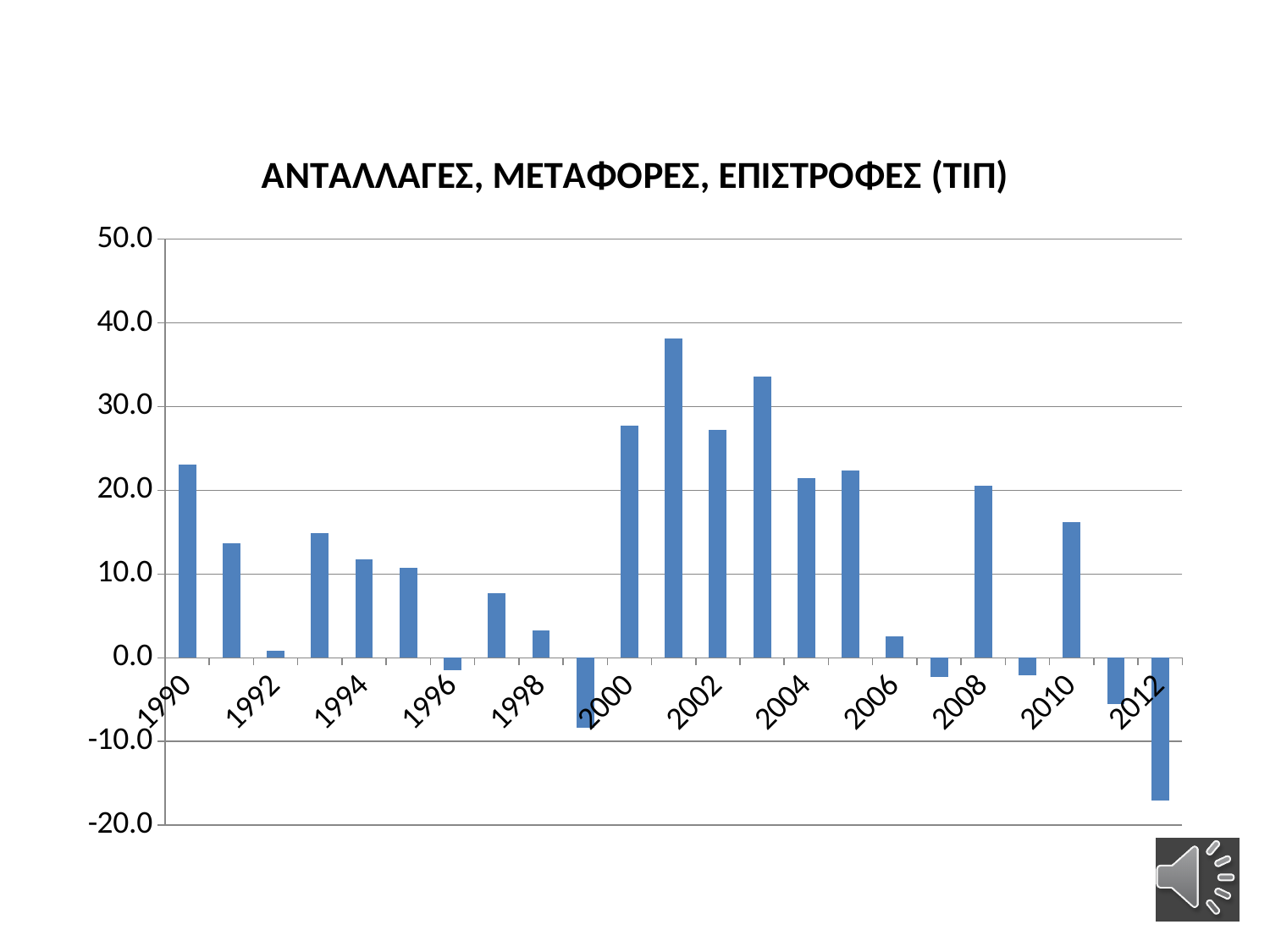
Which is larger, the value for 1990 or the value for 1991? 1990 What type of chart is shown on the slide? bar chart Is the value for 2001 greater or less than 30.0? greater How many bars (years) are plotted in the chart? 23 Is the value for 1990 greater or less than 20.0? greater Is the value for 2012 greater or less than -10.0? less Which year has the lowest value in the chart? 2012 What is the title of the chart? ΑΝΤΑΛΛΑΓΕΣ, ΜΕΤΑΦΟΡΕΣ, ΕΠΙΣΤΡΟΦΕΣ (ΤΙΠ) Do the values rise or fall from 2010 to 2012? fall Which year has the highest value in the chart? 2001 Which is larger, the value for 2001 or the value for 2003? 2001